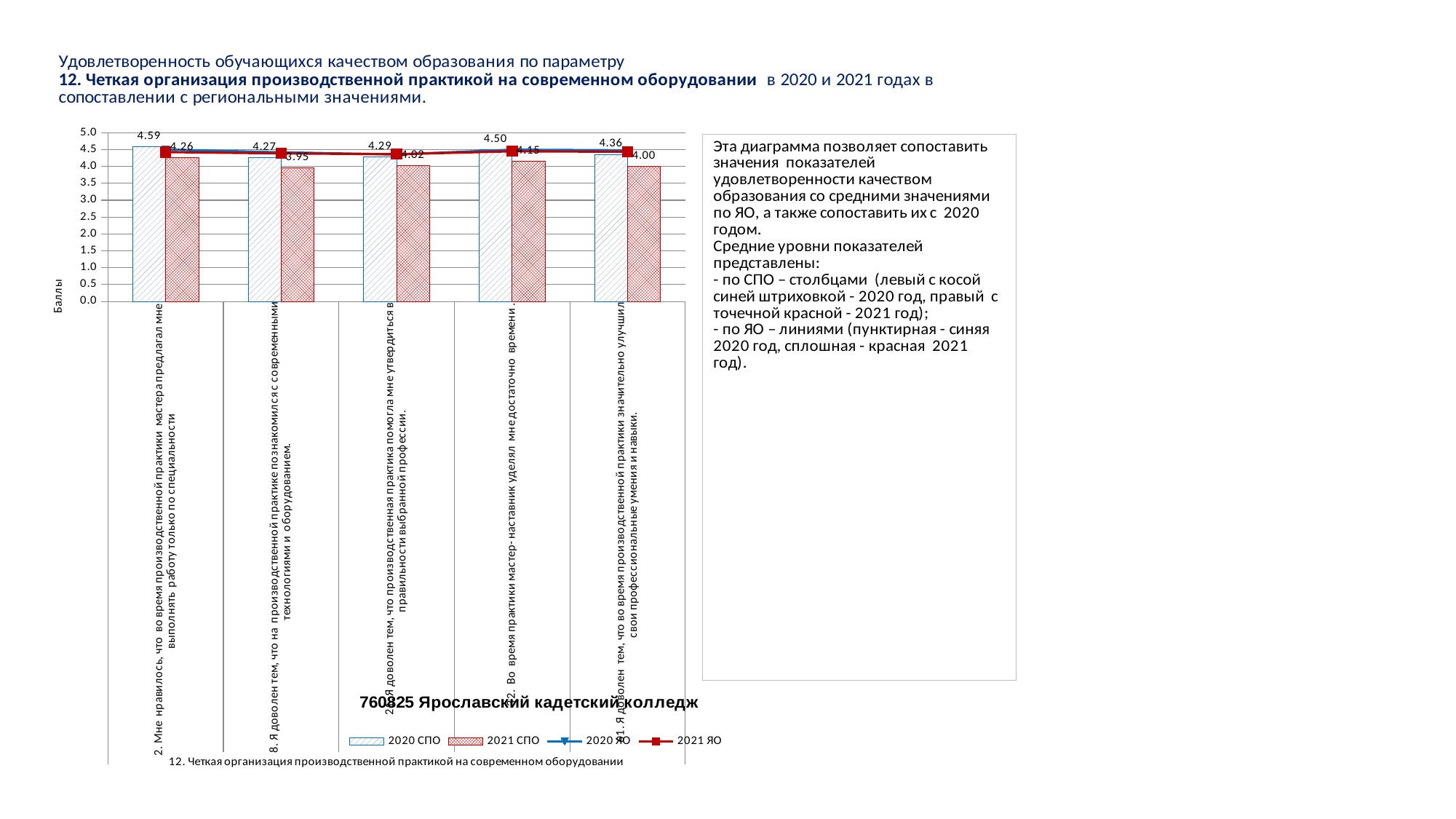
How many series does the legend list? 4 How many statements (categories) are shown on the x axis? 5 What is the 2021 СПО value for statement 41 (Я доволен тем, что во время производственной практики значительно улучшил свои профессиональные умения и навыки)? 4.00 What is the 2021 СПО value for statement 32 (Во время практики мастер-наставник уделял мне достаточно времени)? 4.15 Is the 2021 ЯО line value for statement 8 greater or less than 4.0? greater What is the difference between the 2020 СПО and 2021 СПО values for statement 2? 0.33 What is the label of the y axis? Баллы Which statement has the highest 2020 СПО value? 2. Мне нравилось, что во время производственной практики мастера предлагал мне выполнять работу только по специальности Which statement has the lowest 2021 СПО value? 8. Я доволен тем, что на производственной практике познакомился с современными технологиями и оборудованием What is the 2020 СПО value for statement 8 (Я доволен тем, что на производственной практике познакомился с современными технологиями и оборудованием)? 4.27 What kind of chart is used to show the СПО values? Bar chart